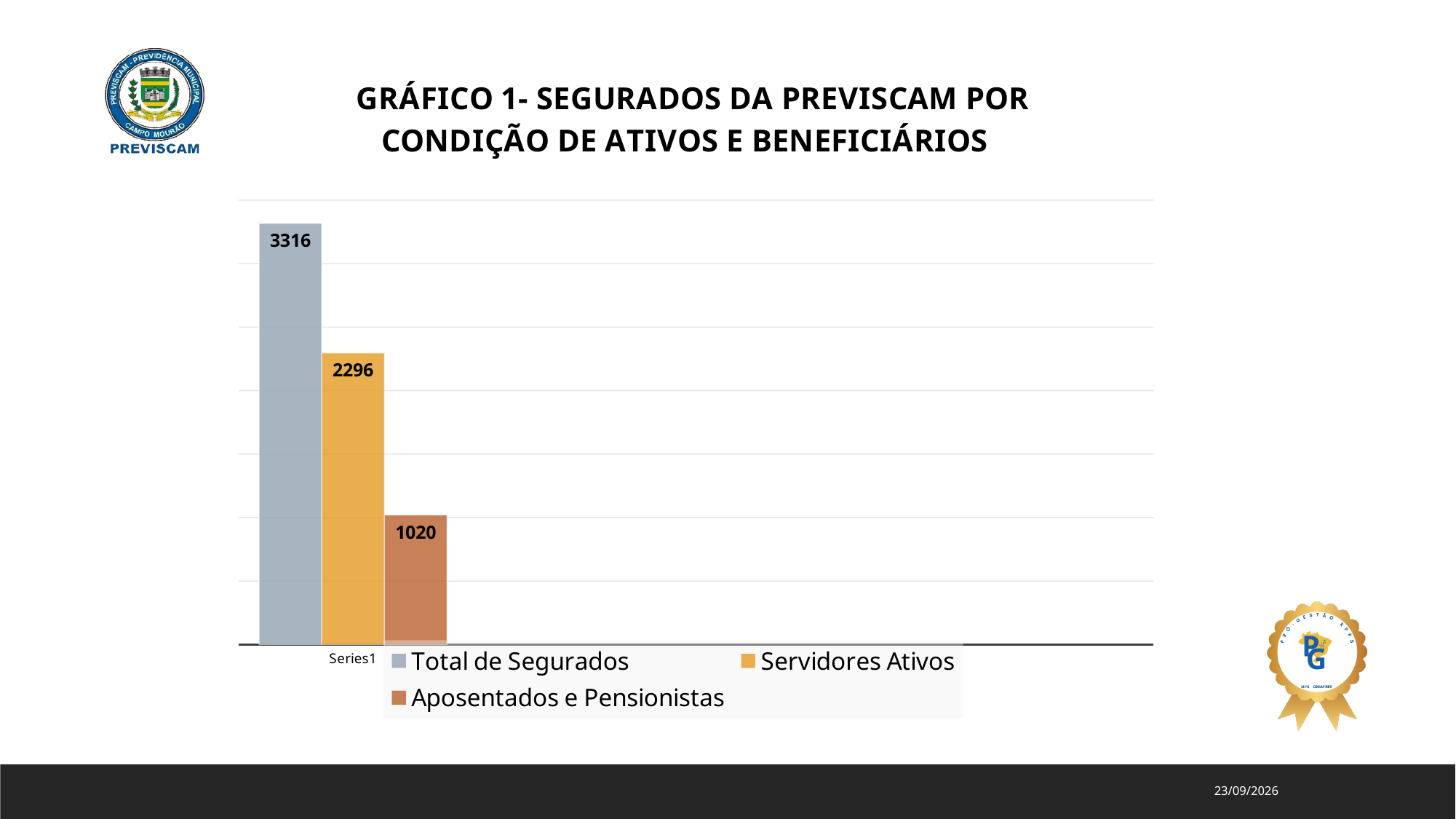
What is the title of the chart? GRÁFICO 1- SEGURADOS DA PREVISCAM POR CONDIÇÃO DE ATIVOS E BENEFICIÁRIOS What is the value for Servidores Ativos? 2296 What is the value for Total de Segurados? 3316 How many series does the legend list? 3 What kind of chart is shown on the slide? bar chart Which series has the highest value? Total de Segurados Which series has the lowest value? Aposentados e Pensionistas What is the value for Aposentados e Pensionistas? 1020 Which is larger, Servidores Ativos or Aposentados e Pensionistas? Servidores Ativos What colour is the bar for Servidores Ativos? orange What is the difference between Total de Segurados and Servidores Ativos? 1020 What is the difference between Servidores Ativos and Aposentados e Pensionistas? 1276